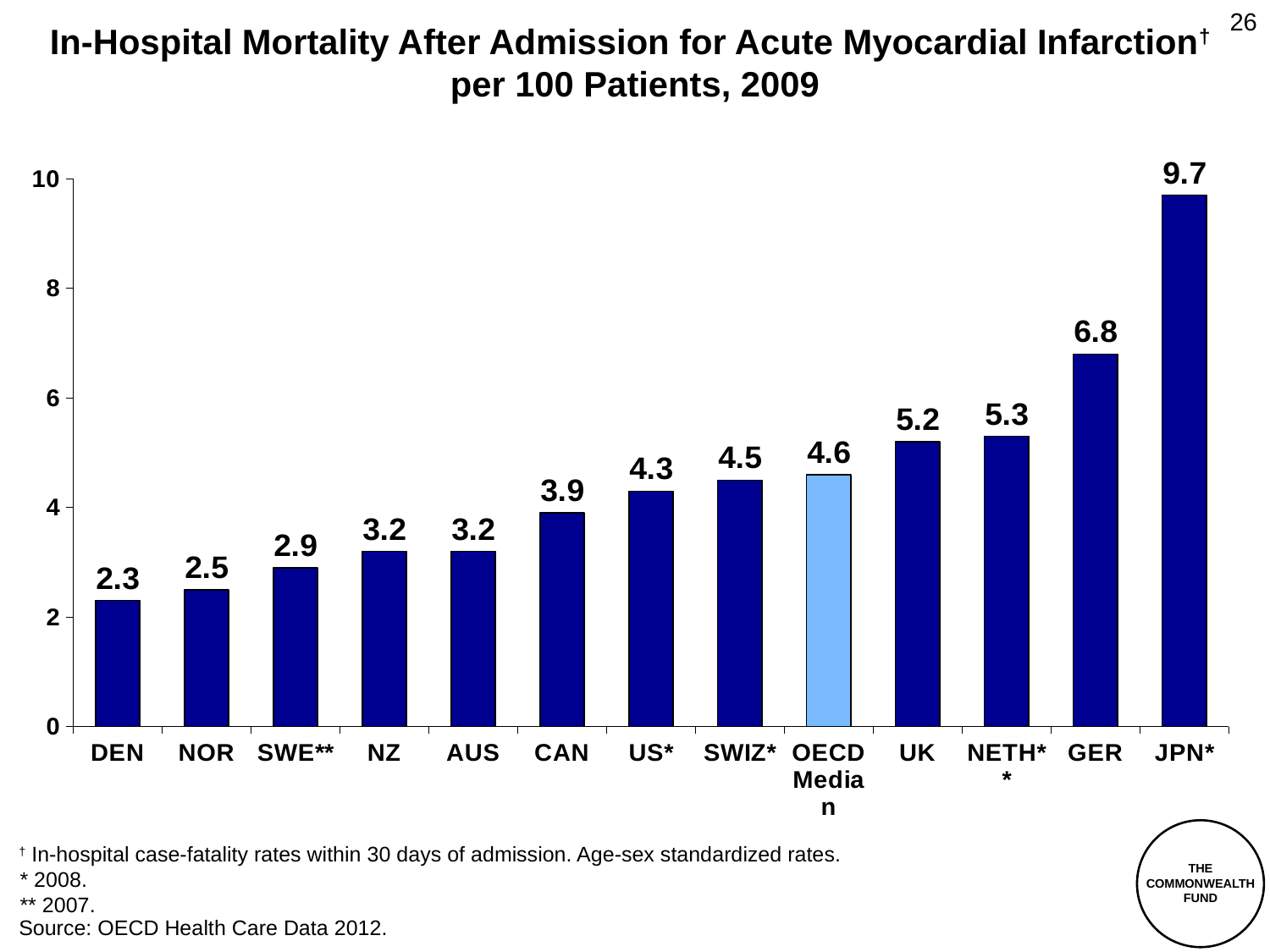
What is the difference between the values for GER and UK? 1.6 What is the value shown for the OECD Median? 4.6 What is the value for CAN? 3.9 Which country has the lowest in-hospital mortality rate on the chart? DEN Which country has the highest in-hospital mortality rate on the chart? JPN* Which bar is shown in a lighter blue colour than the others? OECD Median Do the values generally rise or fall from left to right along the x axis? Rise What is the in-hospital mortality value for JPN*? 9.7 Is the value for NETH** greater or less than 4? greater What kind of chart is shown on the slide? Bar chart Which has a higher value, US* or SWIZ*? SWIZ* How many bars are plotted on the chart? 13